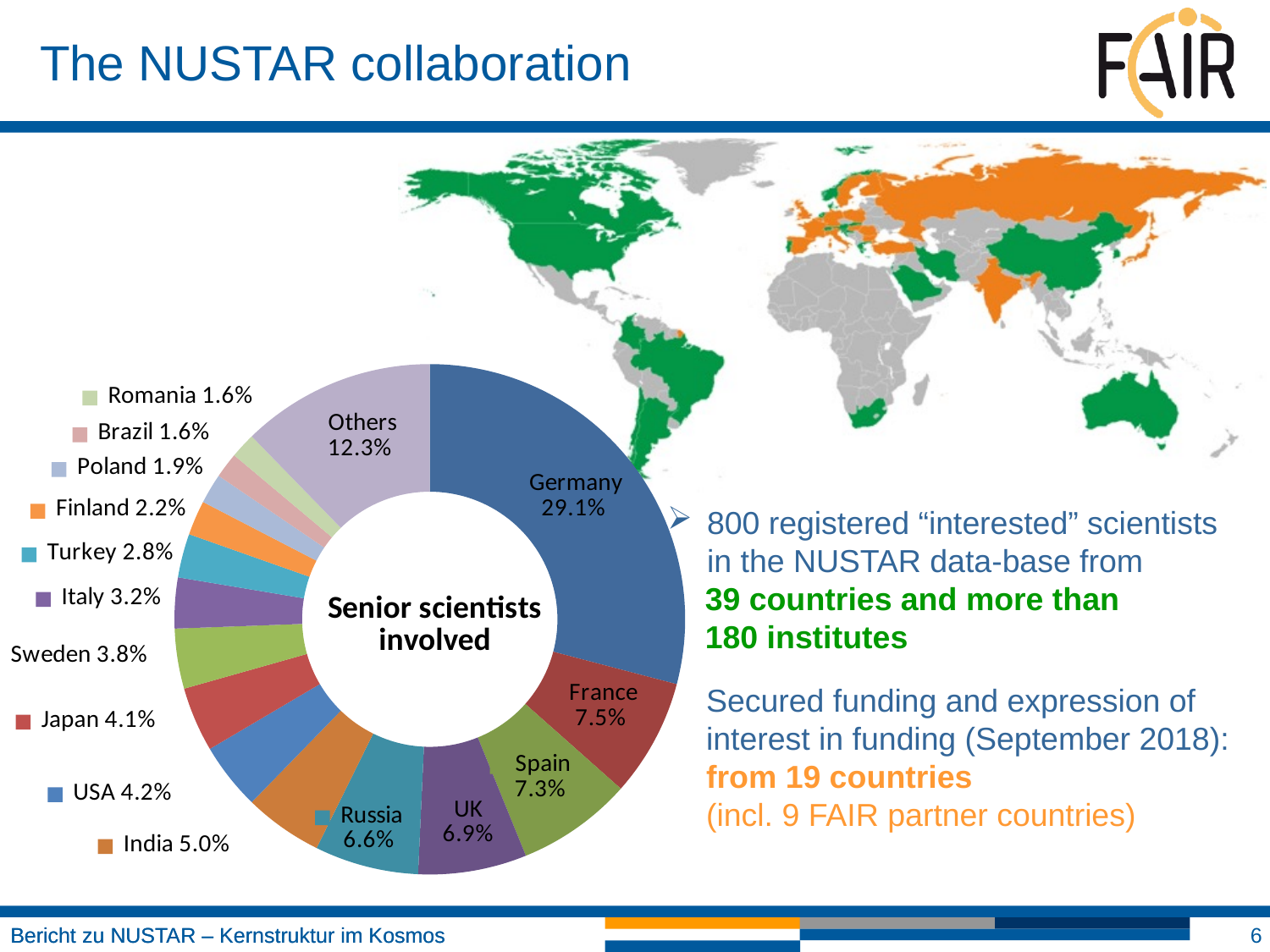
What is the difference between the shares for Germany and France? 21.6% How many slices does the chart have? 16 Which is larger, the share for Spain or the share for UK? Spain What is the value shown for France? 7.5% What is the value shown for Finland? 2.2% What is the title shown in the centre of the chart? Senior scientists involved What kind of chart is shown on the slide? doughnut chart What share of senior scientists involved comes from Germany? 29.1% Which category has the largest share of the chart? Germany What is the value shown for Russia? 6.6% What is the value shown for Others? 12.3% What is the value shown for India? 5.0%